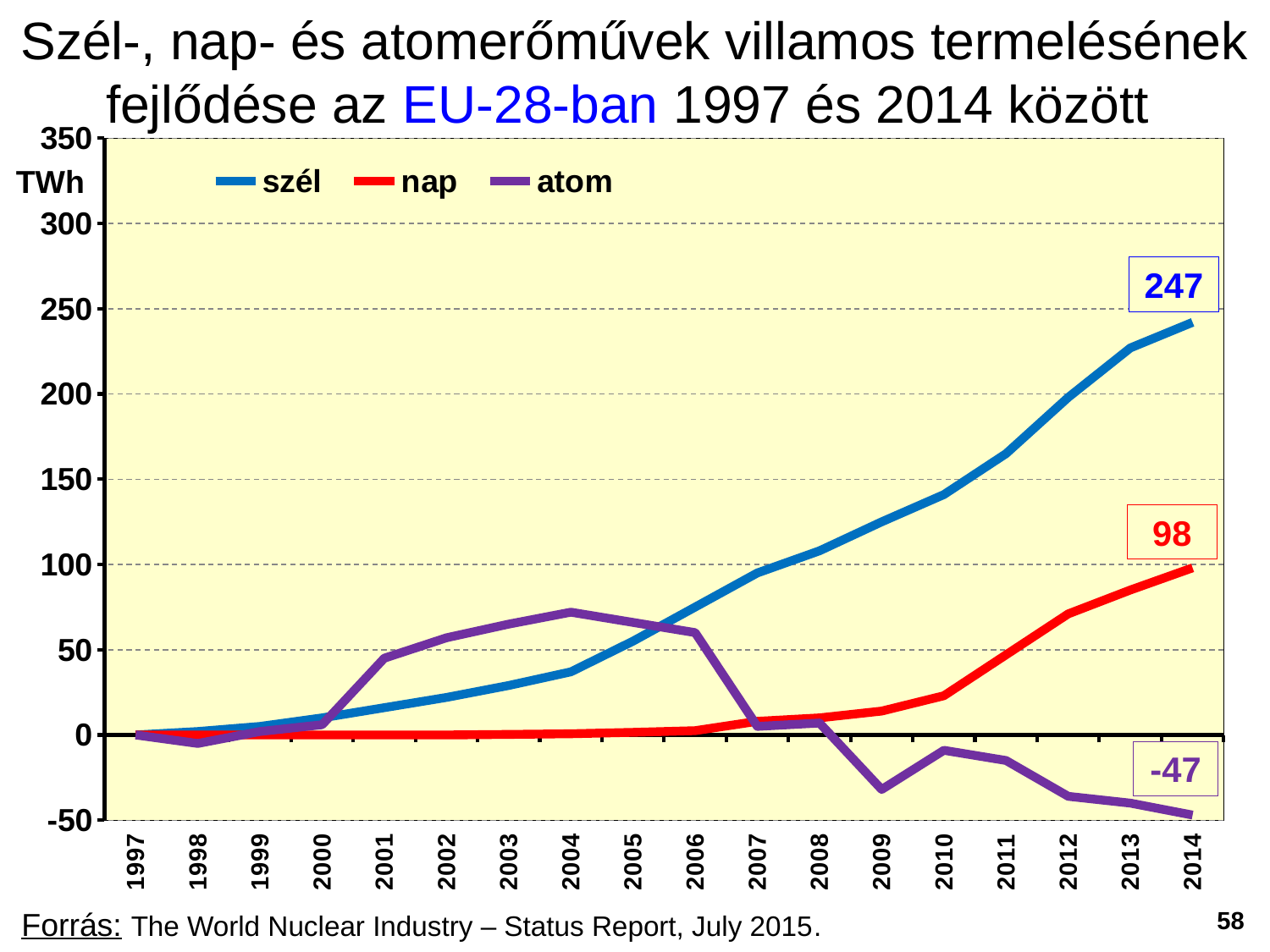
What is the difference between the szél and nap values in 2014? 149 What is the value for szél in 2014? 247 How many years are shown on the x axis? 18 What kind of chart is shown on the slide? line chart Is the value for szél in 2010 greater or less than 100? greater How many series does the legend list? 3 What is the value for nap in 2014? 98 Which series has the highest value in 2014? szél Is the value for nap in 2010 greater or less than 50? less Is the value for atom in 2004 greater or less than 50? greater What is the value for atom in 2014? -47 Which series has the lowest value in 2014? atom